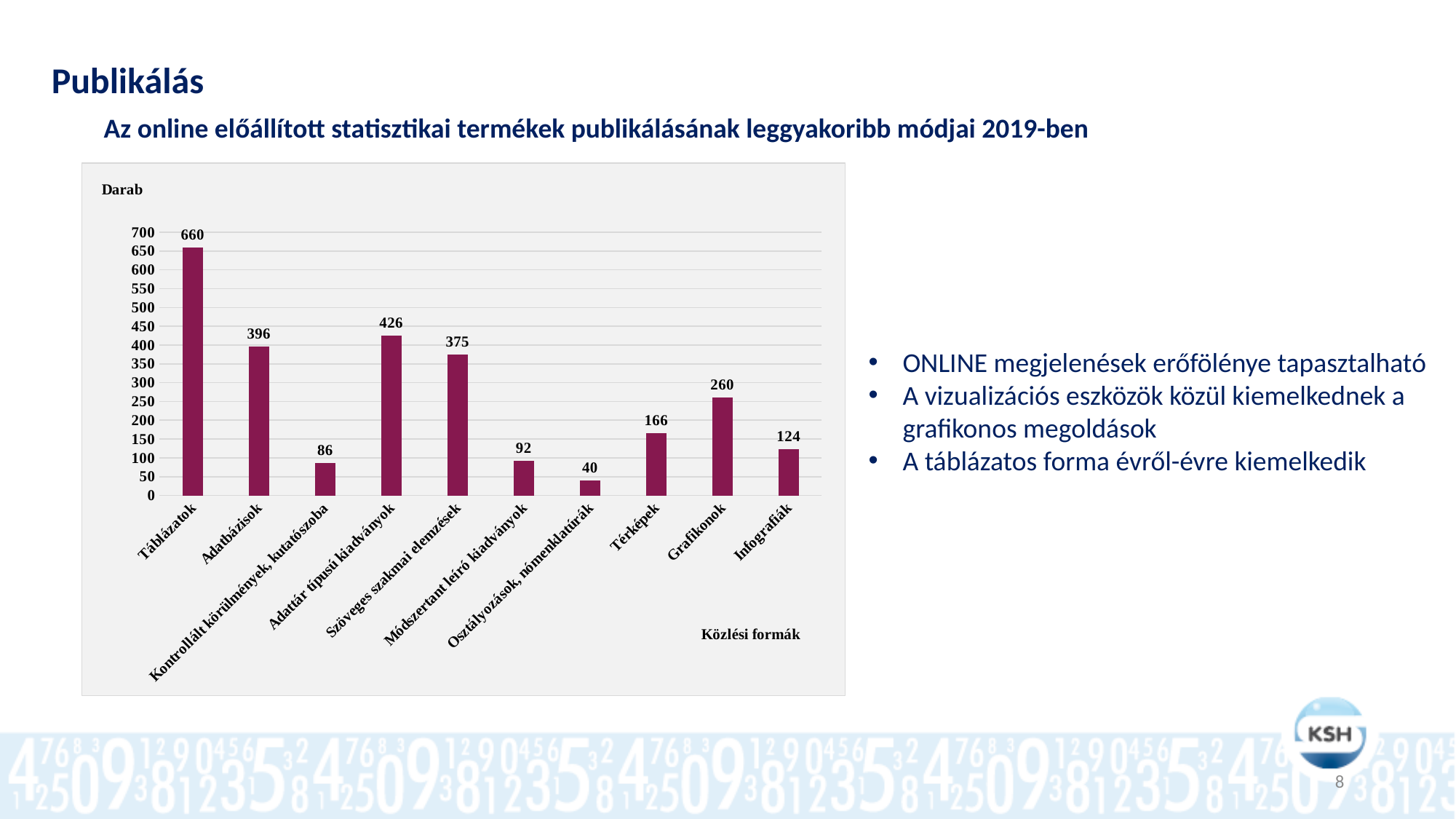
What is the value for Táblázatok? 660 What kind of chart is shown on the slide? bar chart What is the value for Térképek? 166 Which category has the lowest value? Osztályozások, nómenklatúrák Which is larger, the value for Infografikák or the value for Módszertant leíró kiadványok? Infografikák What is the value for Grafikonok? 260 What is the difference between the values for Adattár típusú kiadványok and Adatbázisok? 30 Which category has the highest value? Táblázatok What is the label of the vertical axis? Darab How many categories are shown on the x axis? 10 What is the label of the horizontal axis? Közlési formák Is the value for Szöveges szakmai elemzések greater or less than 400? less